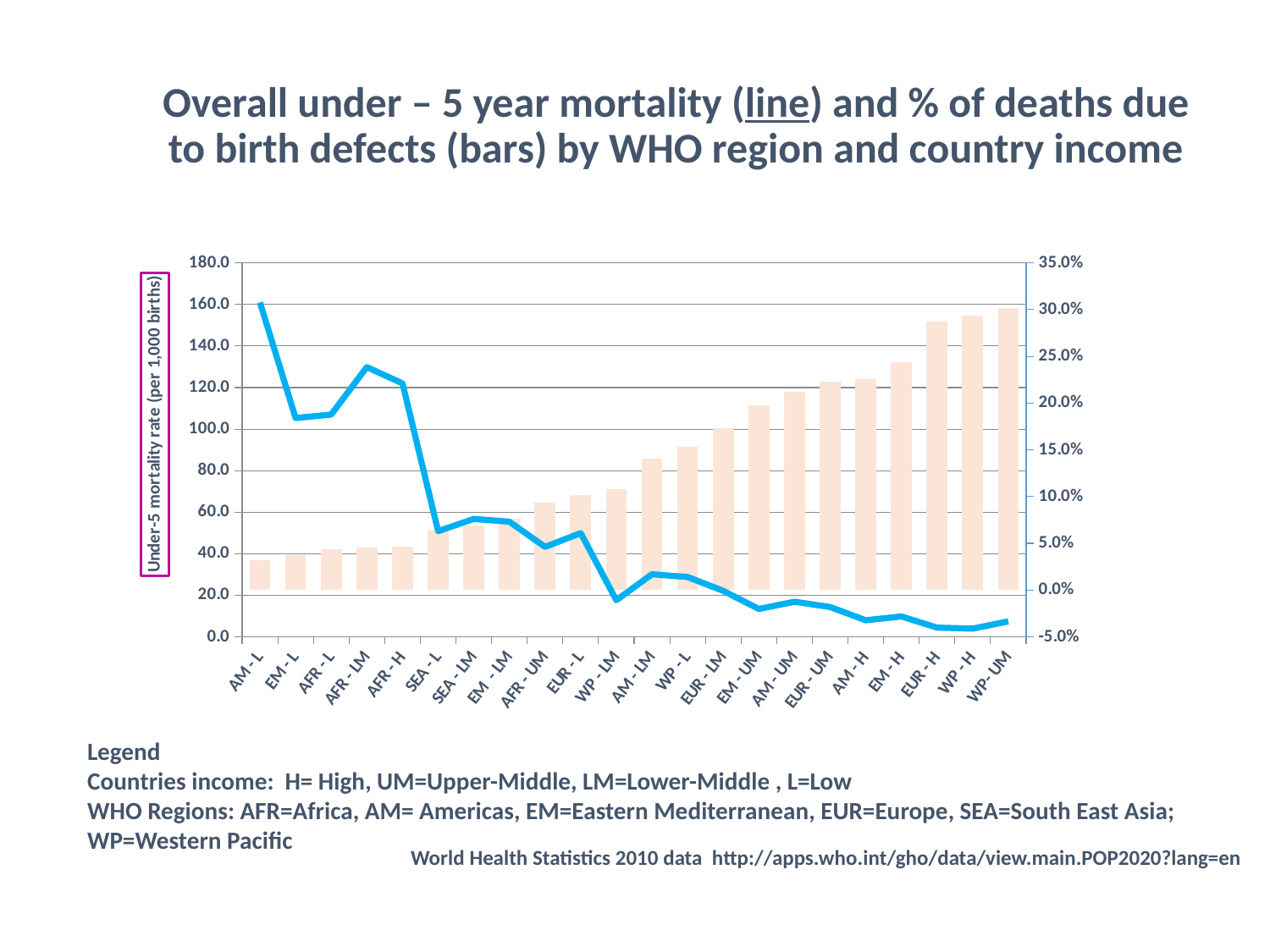
Which category has the lowest % of deaths due to birth defects (bars)? AM - L What kind of chart is shown on the slide? A combined bar and line chart Is the % of deaths due to birth defects (bar) for AM - L greater or less than 5.0%? less Is the under-5 mortality rate (line) for SEA - L greater or less than 60? less Which category has the highest under-5 mortality rate (line)? AM - L Which has a higher under-5 mortality rate (line), AM - L or EM - L? AM - L Which category has the highest % of deaths due to birth defects (bars)? WP - UM Do the bars for % of deaths due to birth defects generally rise or fall from left to right along the x axis? rise How many region-income categories are shown along the x axis? 22 Is the % of deaths due to birth defects (bar) for WP - UM greater or less than 25.0%? greater